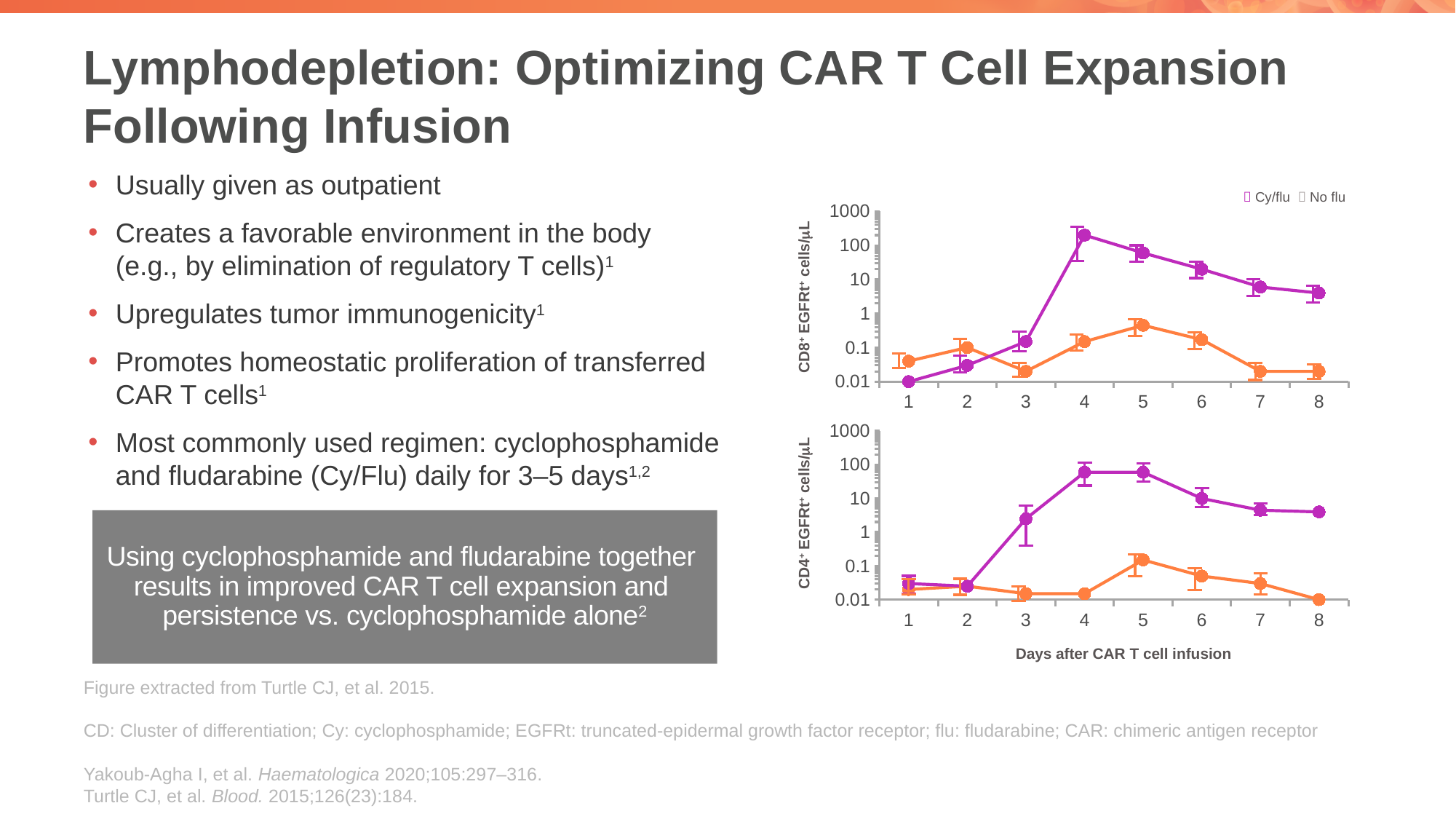
What kind of chart is the top chart (CD8+ EGFRt+ cells/µL)? Line chart In the top chart (CD8+ EGFRt+ cells/µL), is the Cy/flu value on day 5 greater or less than 100? less In the bottom chart (CD4+ EGFRt+ cells/µL), is the Cy/flu value on day 3 greater or less than 1? greater In the bottom chart (CD4+ EGFRt+ cells/µL), does the Cy/flu series rise or fall from day 1 to day 4? Rise In the bottom chart (CD4+ EGFRt+ cells/µL), on which day does the No flu series reach its highest value? Day 5 How many series does the legend list for the charts? 2 What is the x-axis title shared by the two charts? Days after CAR T cell infusion In the top chart (CD8+ EGFRt+ cells/µL), which series has the larger value on day 4, Cy/flu or No flu? Cy/flu In the top chart (CD8+ EGFRt+ cells/µL), does the Cy/flu series rise or fall from day 4 to day 8? Fall In the top chart (CD8+ EGFRt+ cells/µL), is the Cy/flu value on day 4 greater or less than 100? greater In the top chart (CD8+ EGFRt+ cells/µL), on which day does the Cy/flu series reach its highest value? Day 4 In the top chart (CD8+ EGFRt+ cells/µL), how many days are plotted along the x axis? 8